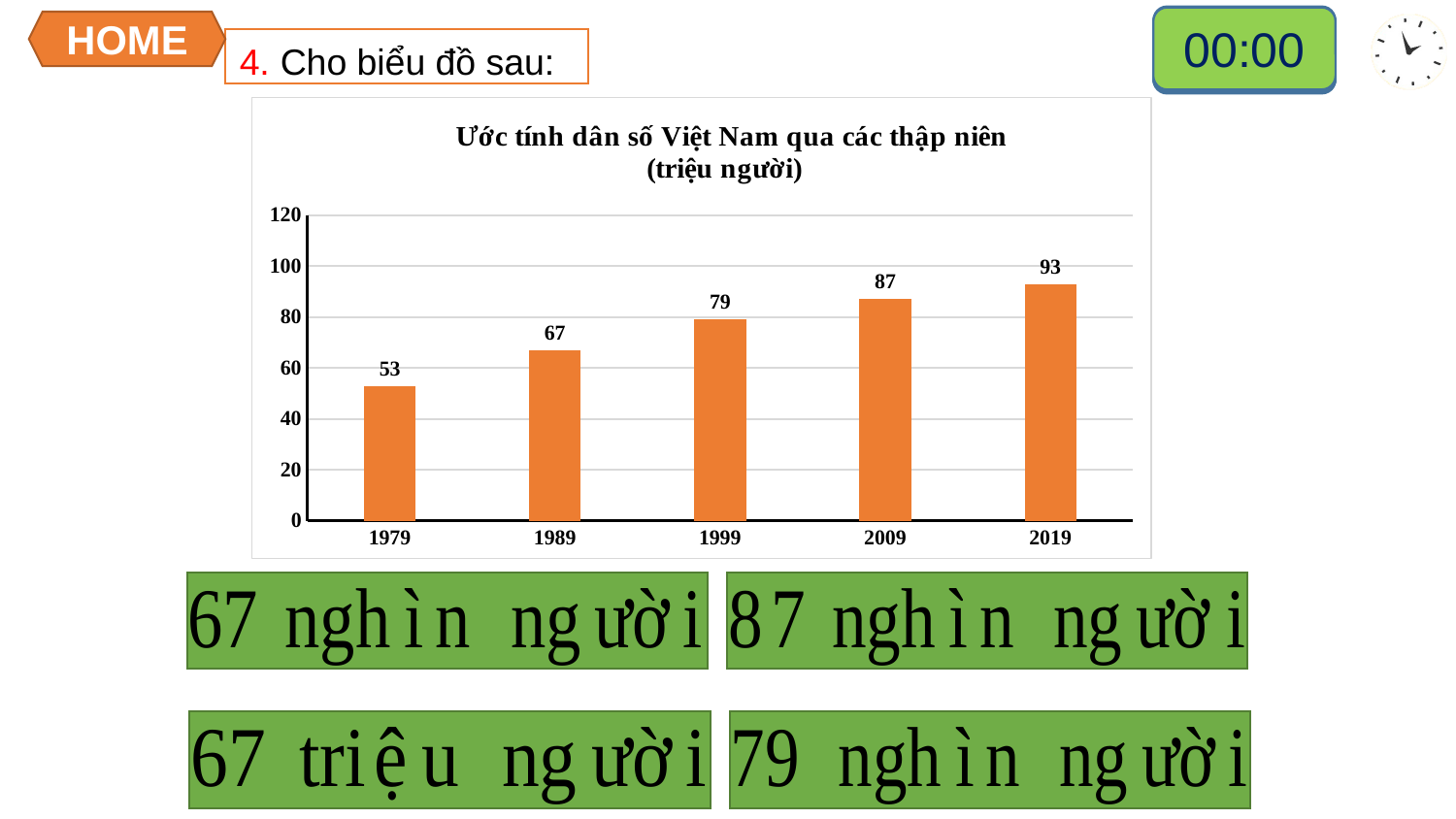
What is the difference between the values for 1989 and 1979? 14 What is the estimated population of Vietnam in 1979 according to the chart? 53 Which year has the highest value on the chart? 2019 Which is larger, the value for 1989 or the value for 2009? 2009 What kind of chart is shown on the slide? bar chart How many years are shown on the x axis of the chart? 5 What is the difference between the values for 2019 and 1979? 40 Which year has the lowest value on the chart? 1979 What value is shown for 2009 on the chart? 87 What value is shown for 1999 on the chart? 79 Do the values rise or fall from 1979 to 2019? rise Is the value for 2019 greater or less than 100? less